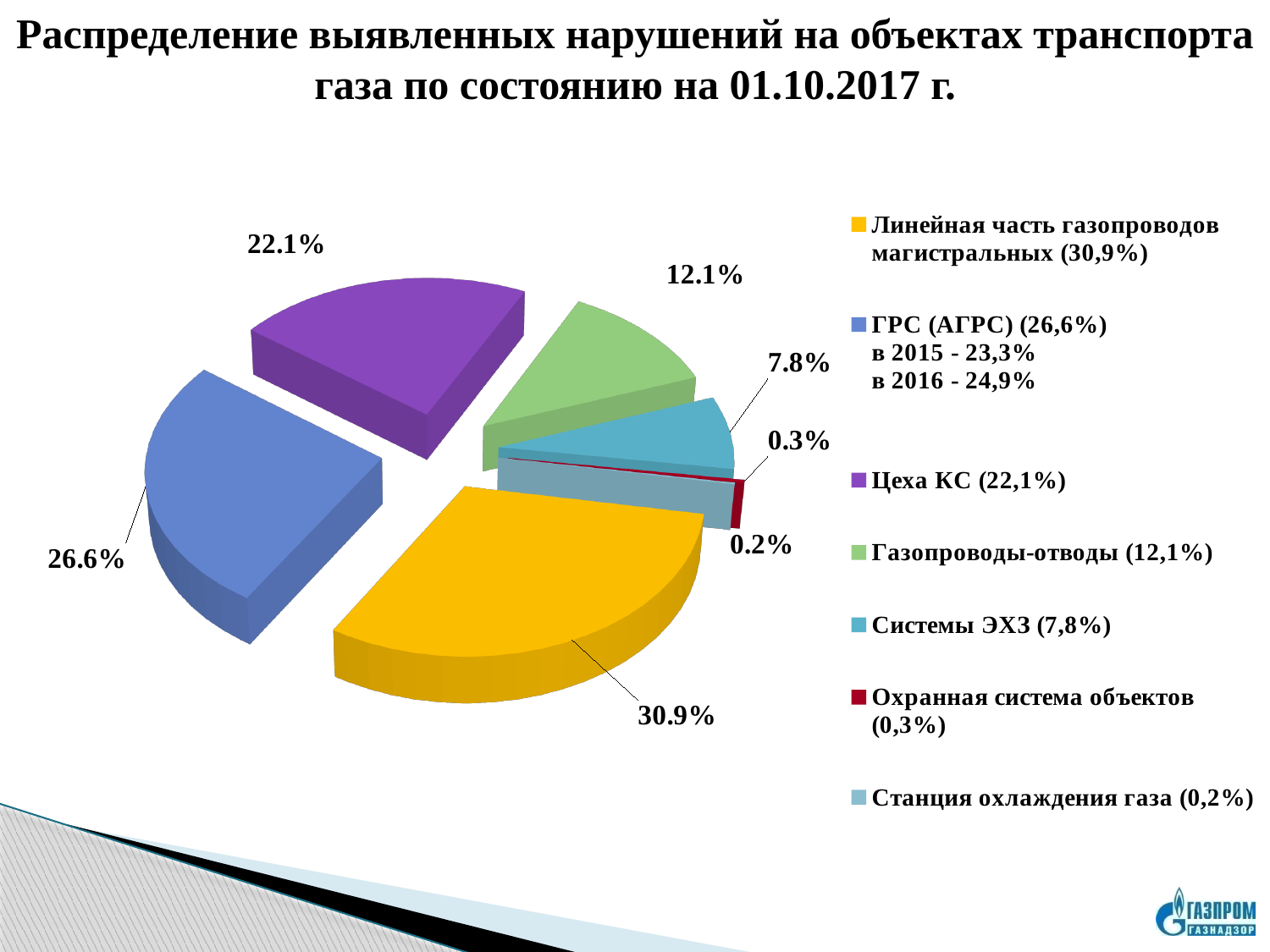
How many categories does the legend list? 7 What colour is the slice for "Цеха КС"? Purple What kind of chart is shown on the slide? Pie chart What is the value shown for "ГРС (АГРС)"? 26.6% What is the value shown for "Станция охлаждения газа"? 0.2% Which is larger, the share for "Газопроводы-отводы" or the share for "Системы ЭХЗ"? Газопроводы-отводы Which category has the smallest share of the pie? Станция охлаждения газа What share of the pie does "Линейная часть газопроводов магистральных" have? 30.9% What is the value shown for "Системы ЭХЗ"? 7.8% What is the value shown for "Цеха КС"? 22.1% What is the difference between the shares of "ГРС (АГРС)" and "Цеха КС"? 4.5% Which category has the largest share of the pie? Линейная часть газопроводов магистральных